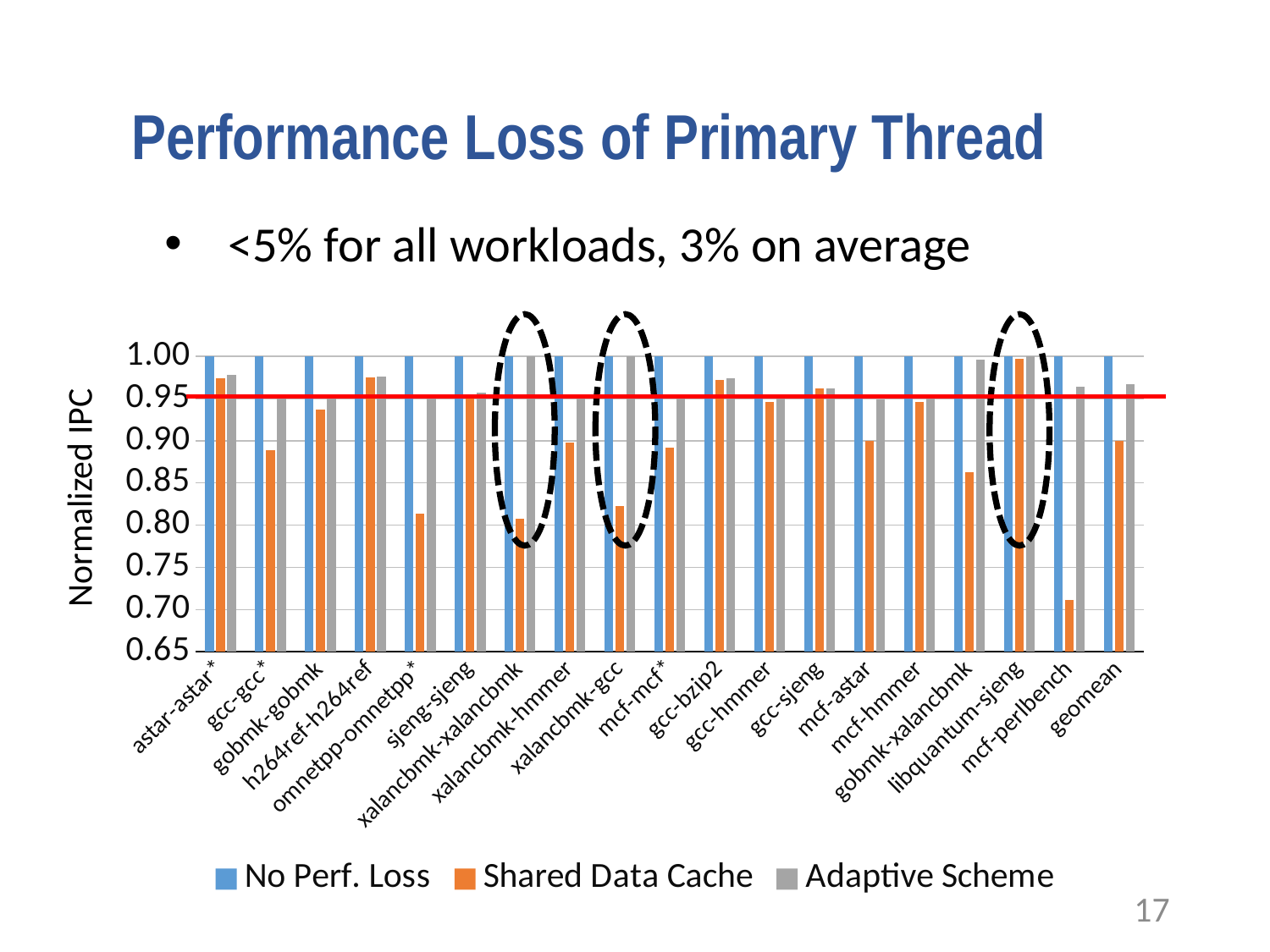
Is the Shared Data Cache value for mcf-perlbench greater or less than 0.75? less Which workload has the lowest Shared Data Cache value? mcf-perlbench For mcf-perlbench, which is larger: the Shared Data Cache value or the Adaptive Scheme value? Adaptive Scheme How many workload categories are shown on the x axis? 19 How many series does the legend list? 3 What is the Normalized IPC value of the No Perf. Loss series for geomean? 1.00 Is the Adaptive Scheme value for geomean greater or less than 0.95? greater What kind of chart is shown on the slide? bar chart Which series is shown in orange in the legend? Shared Data Cache Is the Shared Data Cache value for xalancbmk-xalancbmk greater or less than 0.85? less What is the label of the y axis? Normalized IPC